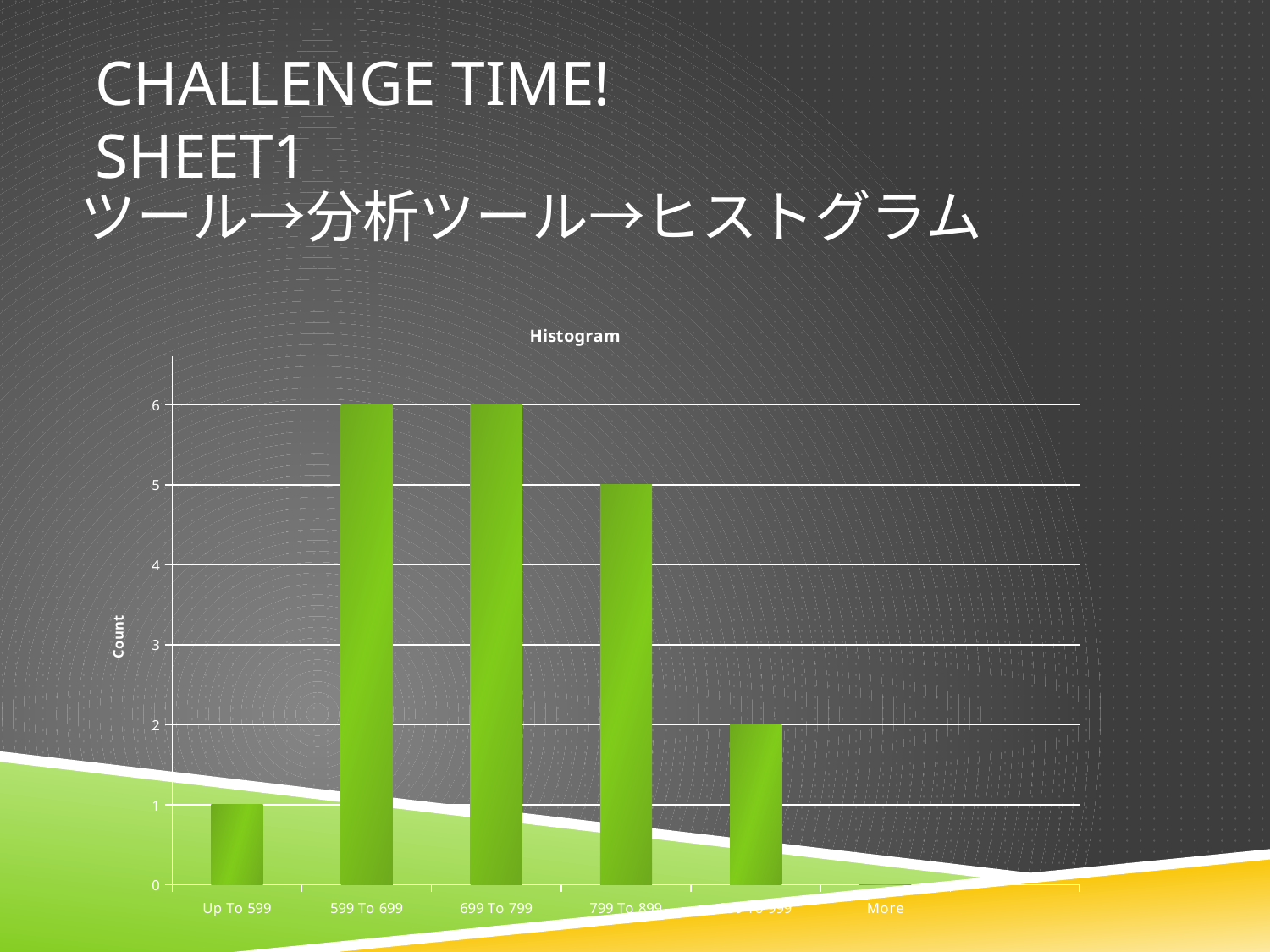
Which is larger, the value for Up To 599 or the value for 799 To 899? 799 To 899 What is the value for the 799 To 899 category? 5 What is the difference between the values for 799 To 899 and Up To 599? 4 What kind of chart is shown on the slide? bar chart What is the value for the 599 To 699 category? 6 Is the value for 799 To 899 greater or less than 3? greater How many categories are shown on the x axis? 6 What is the difference between the values for 599 To 699 and 799 To 899? 1 Is the value for Up To 599 greater or less than 2? less What is the value for the Up To 599 category? 1 What is the title of the chart? Histogram What is the value for the 699 To 799 category? 6